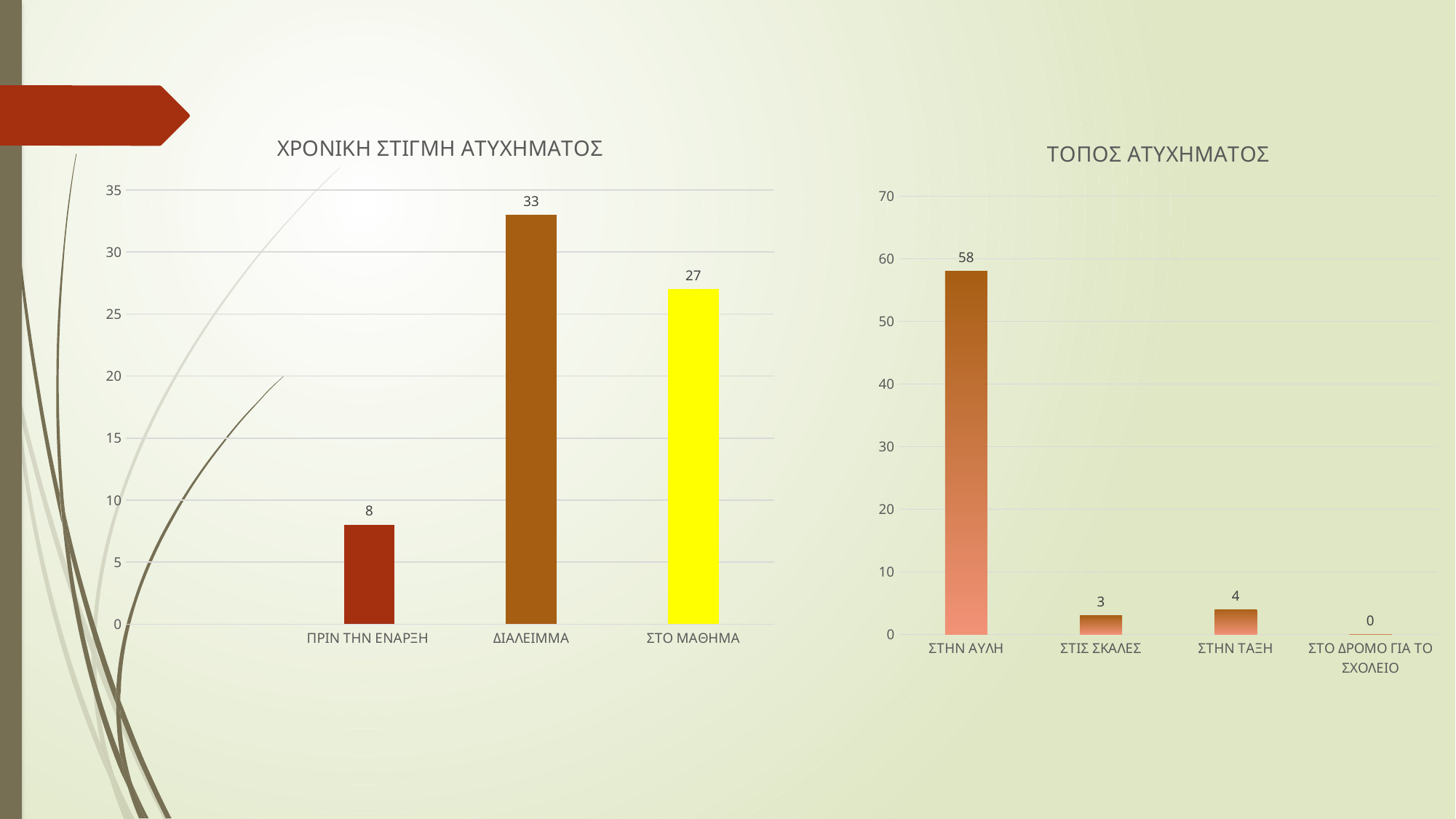
In the chart titled ΤΟΠΟΣ ΑΤΥΧΗΜΑΤΟΣ, which category has the lowest value? ΣΤΟ ΔΡΟΜΟ ΓΙΑ ΤΟ ΣΧΟΛΕΙΟ In the chart titled ΧΡΟΝΙΚΗ ΣΤΙΓΜΗ ΑΤΥΧΗΜΑΤΟΣ, what is the value for ΔΙΑΛΕΙΜΜΑ? 33 In the chart titled ΧΡΟΝΙΚΗ ΣΤΙΓΜΗ ΑΤΥΧΗΜΑΤΟΣ, how many categories are shown? 3 In the chart titled ΤΟΠΟΣ ΑΤΥΧΗΜΑΤΟΣ, what is the value for ΣΤΗΝ ΑΥΛΗ? 58 In the chart titled ΤΟΠΟΣ ΑΤΥΧΗΜΑΤΟΣ, what is the difference between ΣΤΗΝ ΑΥΛΗ and ΣΤΙΣ ΣΚΑΛΕΣ? 55 In the chart titled ΧΡΟΝΙΚΗ ΣΤΙΓΜΗ ΑΤΥΧΗΜΑΤΟΣ, what is the difference between ΔΙΑΛΕΙΜΜΑ and ΣΤΟ ΜΑΘΗΜΑ? 6 In the chart titled ΧΡΟΝΙΚΗ ΣΤΙΓΜΗ ΑΤΥΧΗΜΑΤΟΣ, which category has the highest value? ΔΙΑΛΕΙΜΜΑ In the chart titled ΤΟΠΟΣ ΑΤΥΧΗΜΑΤΟΣ, how many categories are shown? 4 In the chart titled ΤΟΠΟΣ ΑΤΥΧΗΜΑΤΟΣ, what is the value for ΣΤΗΝ ΤΑΞΗ? 4 In the chart titled ΤΟΠΟΣ ΑΤΥΧΗΜΑΤΟΣ, which is larger, ΣΤΙΣ ΣΚΑΛΕΣ or ΣΤΗΝ ΤΑΞΗ? ΣΤΗΝ ΤΑΞΗ In the chart titled ΧΡΟΝΙΚΗ ΣΤΙΓΜΗ ΑΤΥΧΗΜΑΤΟΣ, what is the value for ΠΡΙΝ ΤΗΝ ΕΝΑΡΞΗ? 8 In the chart titled ΧΡΟΝΙΚΗ ΣΤΙΓΜΗ ΑΤΥΧΗΜΑΤΟΣ, what kind of chart is it? Bar chart